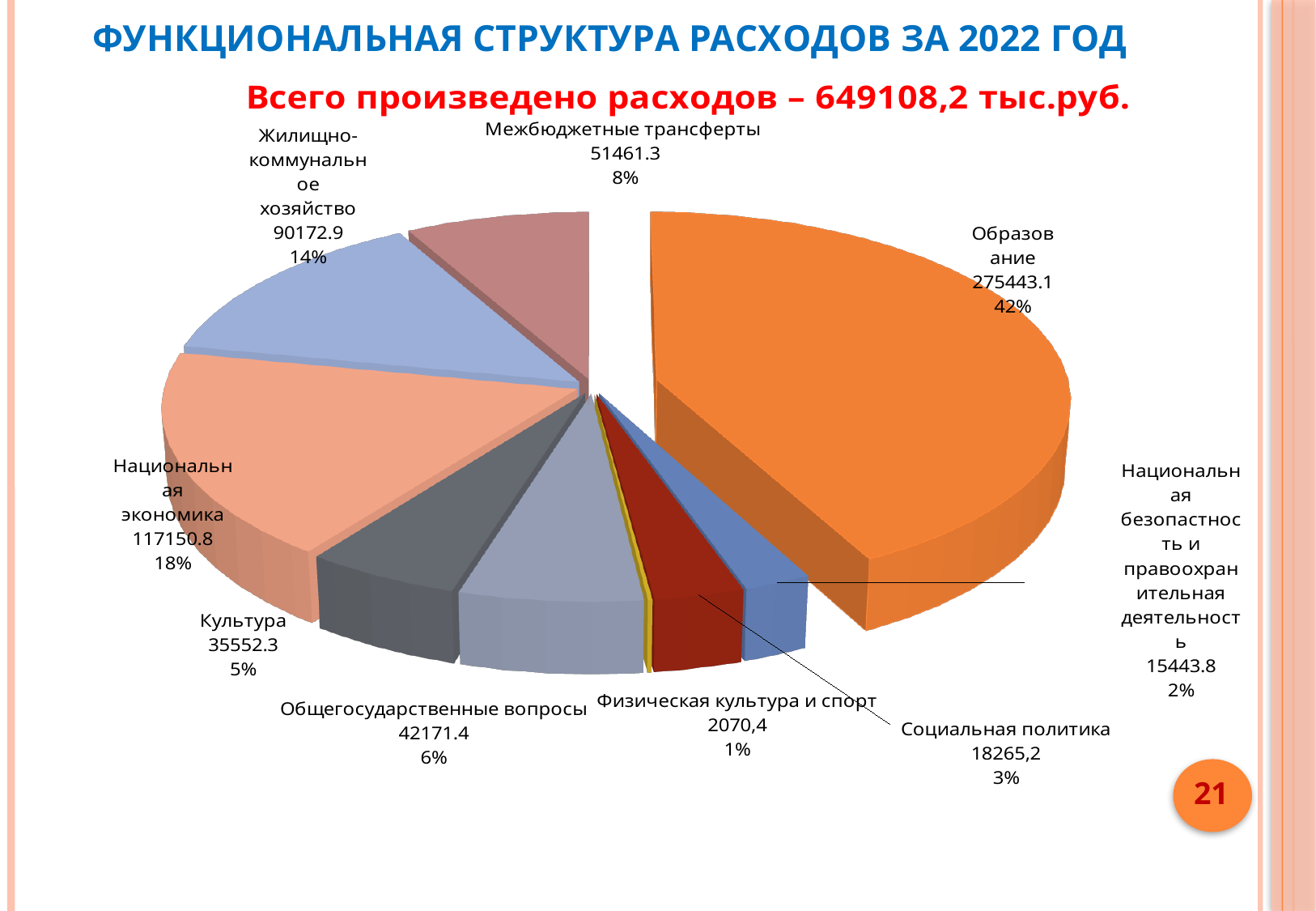
What is the value for Жилищно-коммунальное хозяйство? 90172.9 Which category has the smallest slice of the pie? Физическая культура и спорт Which is larger, the value for Межбюджетные трансферты or the value for Социальная политика? Межбюджетные трансферты What is the value for Национальная безопасность и правоохранительная деятельность? 15443.8 What is the difference between the values for Общегосударственные вопросы and Культура? 6619.1 Which category has the largest slice of the pie? Образование What kind of chart is shown on the slide? pie chart What share of the pie does Национальная экономика have? 18% How many categories (slices) does the pie chart show? 9 What total expenditure amount is stated in the chart's subtitle? 649108,2 тыс.руб. What is the value for Образование? 275443.1 What share of the pie does Межбюджетные трансферты have? 8%